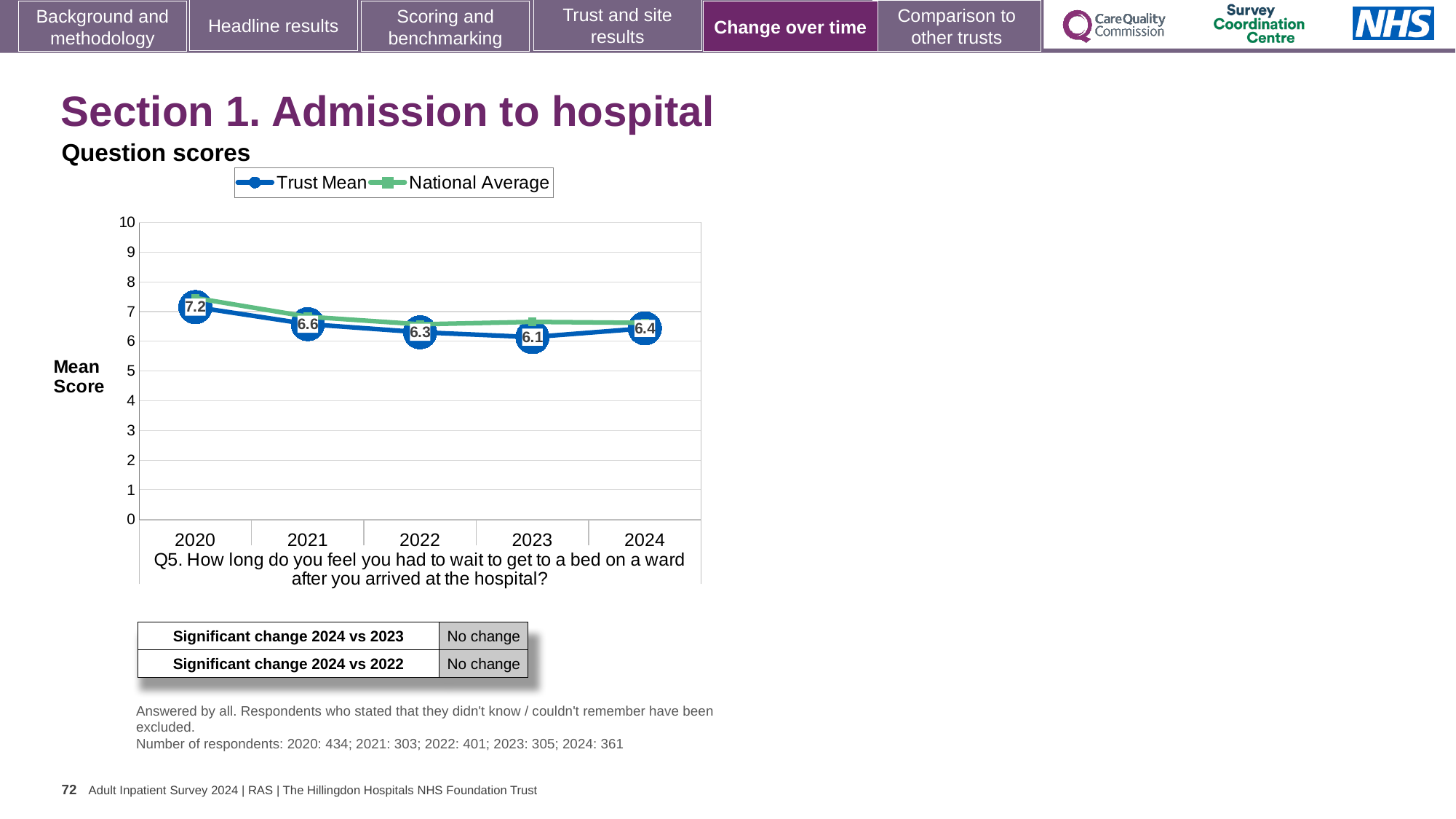
What is the Trust Mean score for 2020? 7.2 What is the Trust Mean score for 2023? 6.1 What is the Trust Mean score for 2024? 6.4 How many series does the legend list? 2 Is the National Average value for 2020 greater or less than 7? greater What kind of chart is shown on the slide? Line chart Does the Trust Mean score rise or fall from 2020 to 2023? Fall In which year is the Trust Mean score lowest? 2023 What is the difference between the Trust Mean scores for 2020 and 2024? 0.8 Which year has the larger Trust Mean score, 2021 or 2022? 2021 In which year is the Trust Mean score highest? 2020 How many years are plotted on the x axis? 5